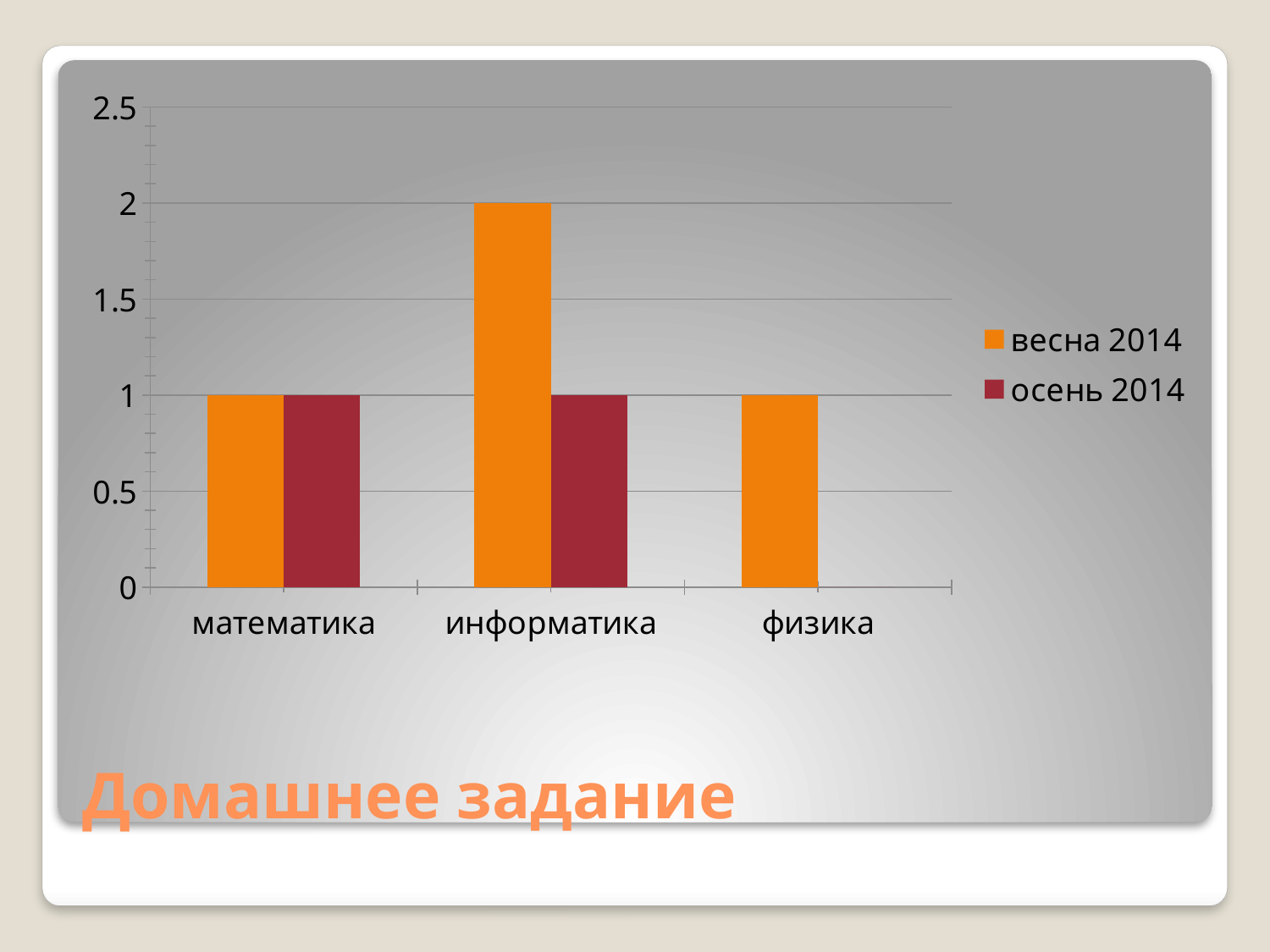
Which is larger for информатика: the весна 2014 value or the осень 2014 value? весна 2014 How many series does the legend list? 2 What kind of chart is shown on the slide? bar chart What is the difference between the весна 2014 and осень 2014 values for информатика? 1 Is the value for информатика in the весна 2014 series greater or less than 1.5? greater What is the value for физика in the весна 2014 series? 1 Which category has the highest value in the весна 2014 series? информатика What is the value for математика in the весна 2014 series? 1 Which series is shown in orange in the legend? весна 2014 How many categories are shown on the x axis? 3 What is the value for информатика in the осень 2014 series? 1 What is the value for информатика in the весна 2014 series? 2